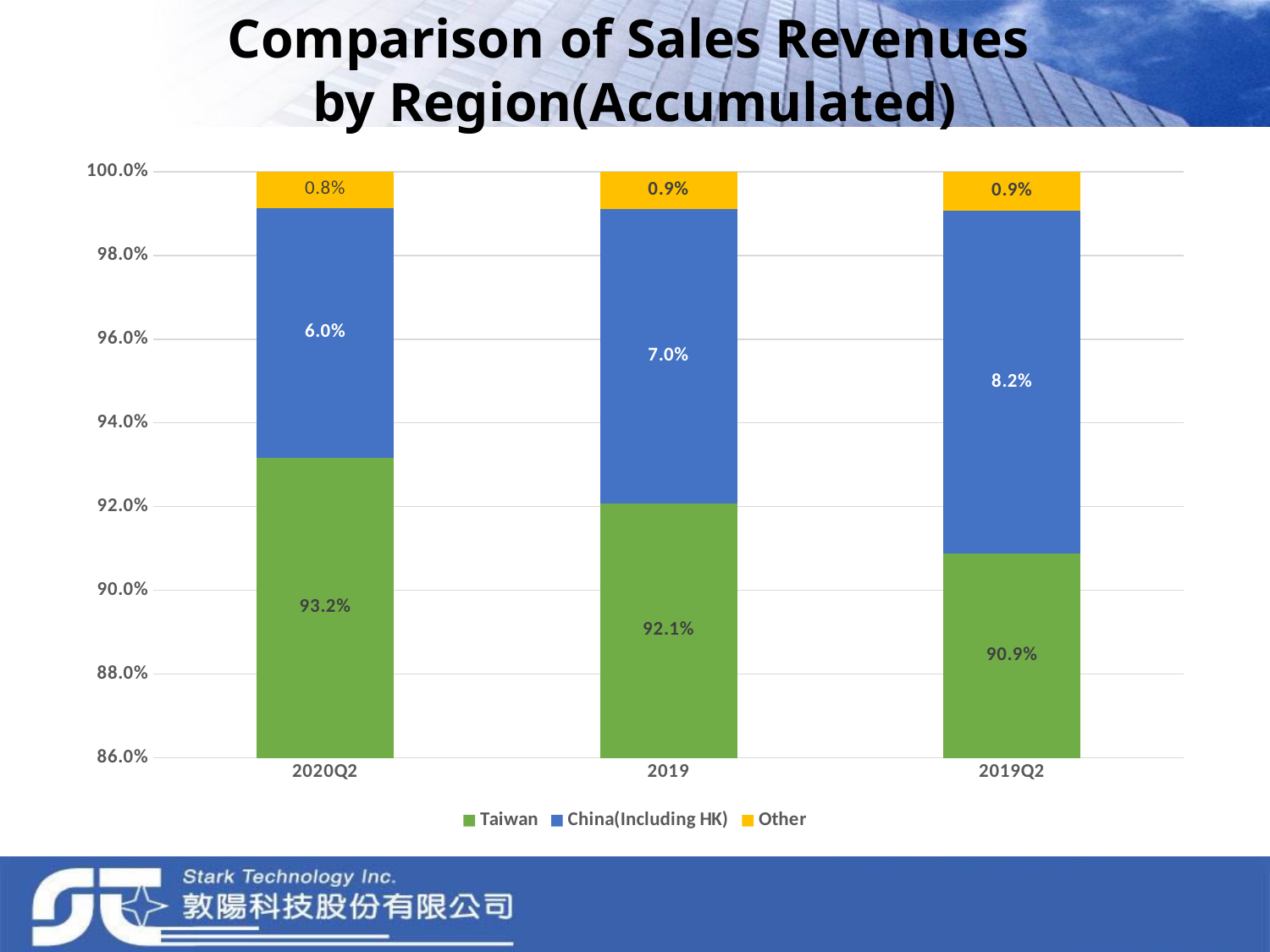
How many series does the legend list? 3 What is the Other share of sales revenue for 2019? 0.9% What is the China(Including HK) share of sales revenue for 2019Q2? 8.2% Which period has the highest Taiwan share? 2020Q2 What is the Taiwan share of sales revenue for 2020Q2? 93.2% How many periods are shown on the x axis? 3 Which is larger, the China(Including HK) share in 2019 or in 2019Q2? 2019Q2 Does the Taiwan share rise or fall moving from 2020Q2 to 2019Q2 along the x axis? Fall What is the difference between the Taiwan share in 2020Q2 and in 2019Q2? 2.3% Which colour represents Other in the legend? Yellow Which period has the lowest China(Including HK) share? 2020Q2 What kind of chart is shown on the slide? Stacked bar chart